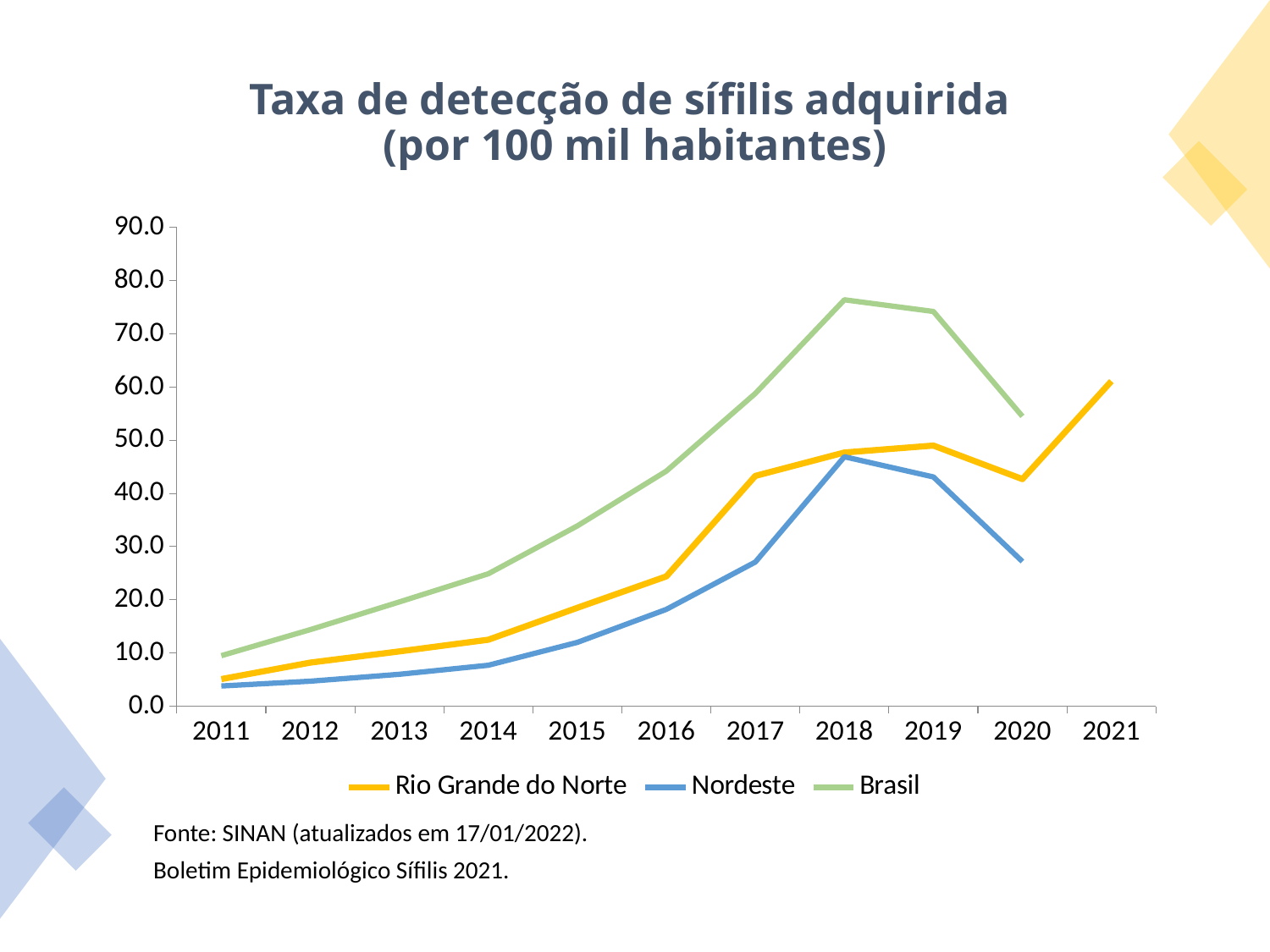
In which year does the Brasil series reach its highest value? 2018 In which year is the Nordeste series at its lowest value? 2011 In 2017, which series has the larger value, Rio Grande do Norte or Nordeste? Rio Grande do Norte Does the Brasil series rise or fall from 2011 to 2018? Rise In which year does the Rio Grande do Norte series reach its highest value? 2021 Is the value for Brasil in 2018 greater or less than 70.0? greater In 2020, which series has the larger value, Brasil or Rio Grande do Norte? Brasil How many series does the legend list? 3 Is the value for Nordeste in 2020 greater or less than 30.0? less How many years are shown on the x axis? 11 Is the value for Rio Grande do Norte in 2021 greater or less than 50.0? greater What kind of chart is shown on the slide? Line chart